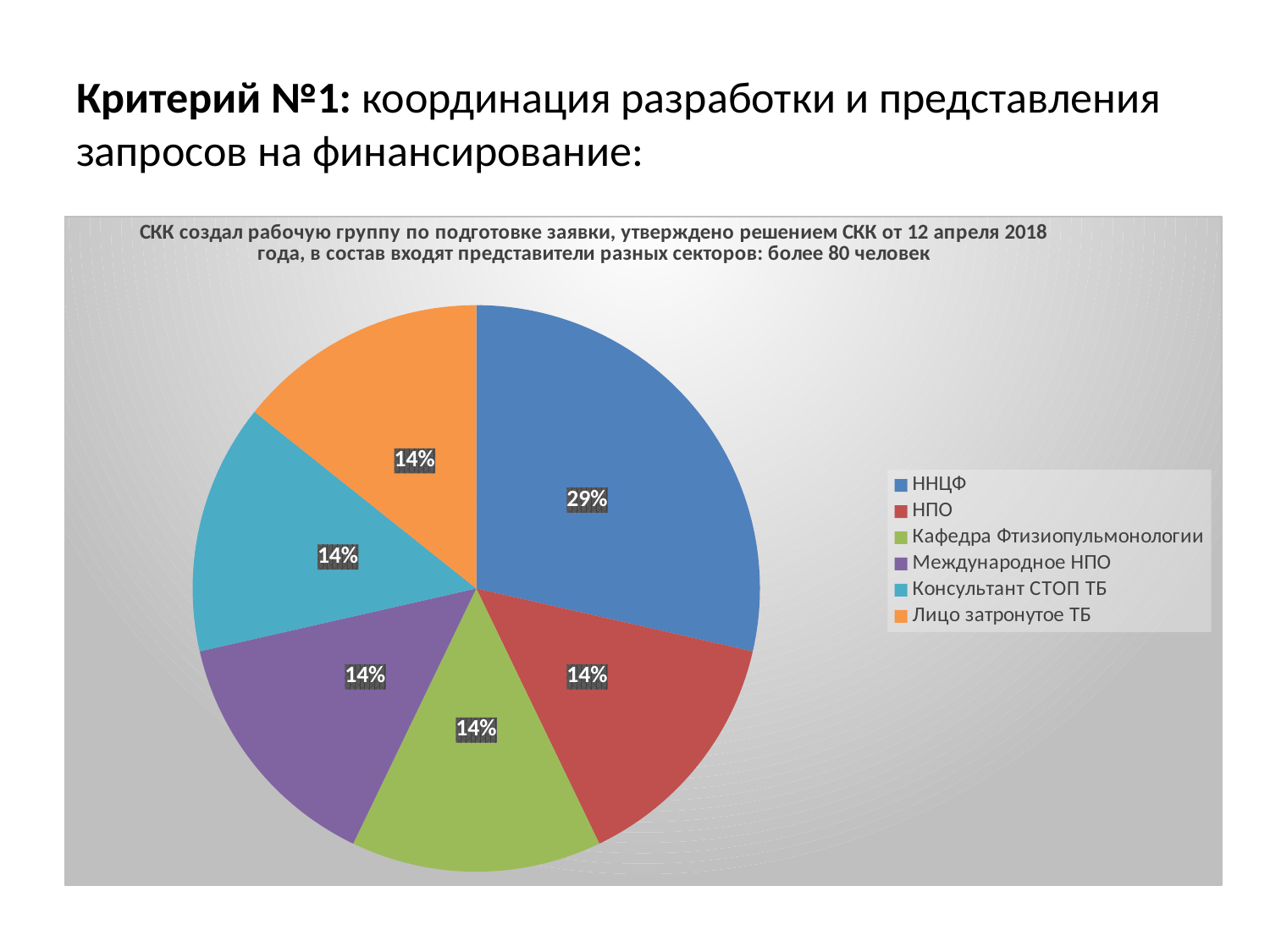
What share of the pie does Лицо затронутое ТБ have? 14% Which colour represents Консультант СТОП ТБ in the pie chart? light blue What share of the pie does НПО have? 14% According to the chart title, how many people are in the working group? более 80 человек What share of the pie does Кафедра Фтизиопульмонологии have? 14% How many categories are listed in the legend? 6 What kind of chart is shown on the slide? pie chart Which category has the largest share of the pie? ННЦФ What share of the pie does ННЦФ have? 29% What is the difference in percentage points between the share of ННЦФ and the share of Международное НПО? 15 How many slices does the pie chart have? 6 Which has a larger share, ННЦФ or Консультант СТОП ТБ? ННЦФ